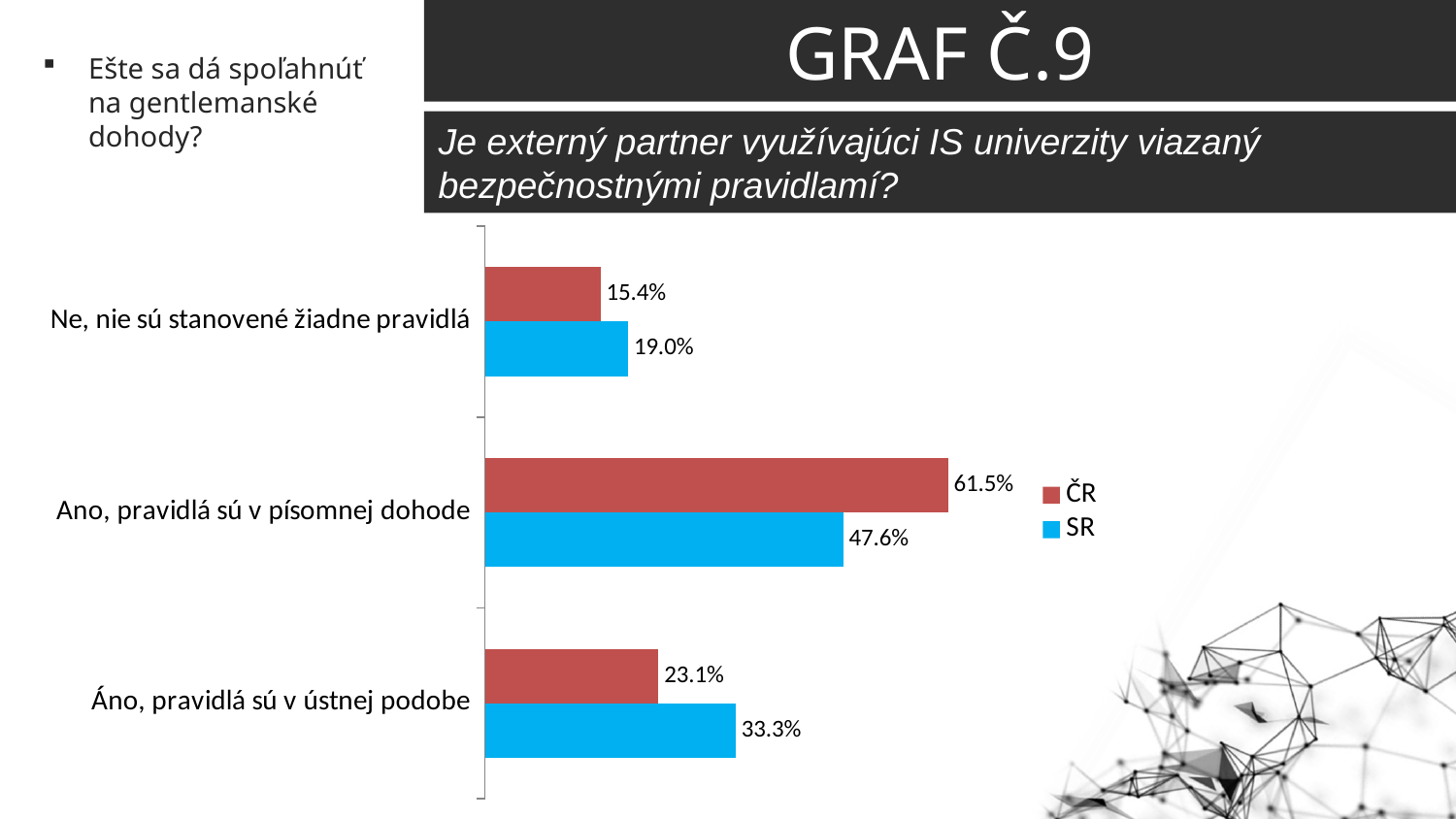
What is the ČR value for "Ano, pravidlá sú v písomnej dohode"? 61.5% For "Áno, pravidlá sú v ústnej podobe", which series has the larger value, ČR or SR? SR What is the SR value for "Ne, nie sú stanovené žiadne pravidlá"? 19.0% What is the SR value for "Áno, pravidlá sú v ústnej podobe"? 33.3% What is the difference between the ČR and SR values for "Ano, pravidlá sú v písomnej dohode"? 13.9% What is the difference between the SR and ČR values for "Ne, nie sú stanovené žiadne pravidlá"? 3.6% How many categories are shown in the chart? 3 How many series does the legend list? 2 What kind of chart is shown on the slide? Bar chart Which category has the highest ČR value? Ano, pravidlá sú v písomnej dohode Which category has the lowest SR value? Ne, nie sú stanovené žiadne pravidlá Which series is shown in blue in the legend? SR